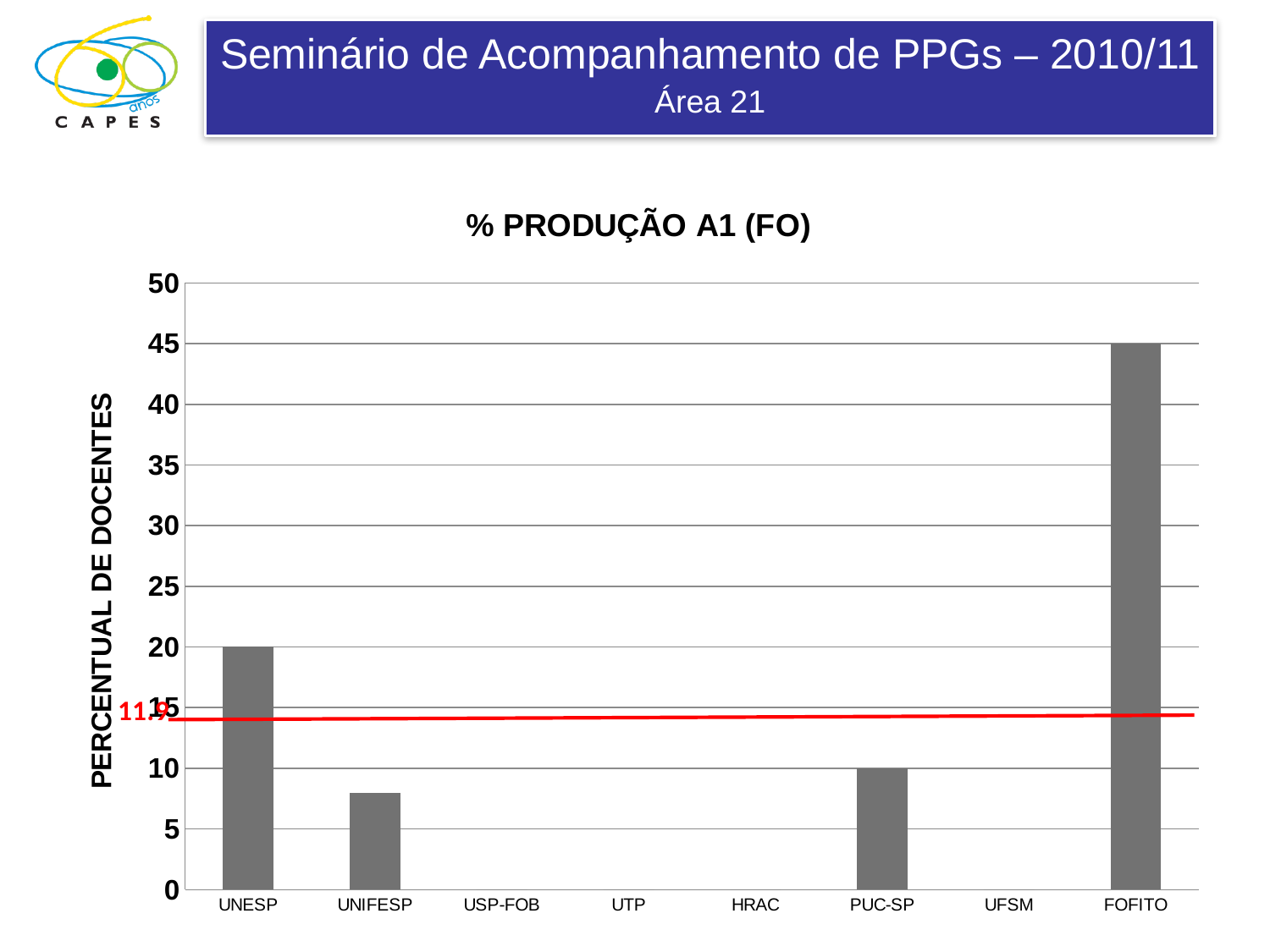
Is the value for UNIFESP greater or less than 10? less What is the value for UNESP? 20 Which category has the highest value in the chart? FOFITO What kind of chart is shown on the slide? bar chart How many categories show no visible bar (a value of 0)? 4 What is the value for FOFITO? 45 What value is labelled on the red horizontal line in the chart? 11.9 What is the title of the y axis? PERCENTUAL DE DOCENTES What is the difference between the values for FOFITO and UNESP? 25 How many categories are shown on the x axis of the chart? 8 Which is larger, the value for UNESP or the value for PUC-SP? UNESP What is the value for PUC-SP? 10